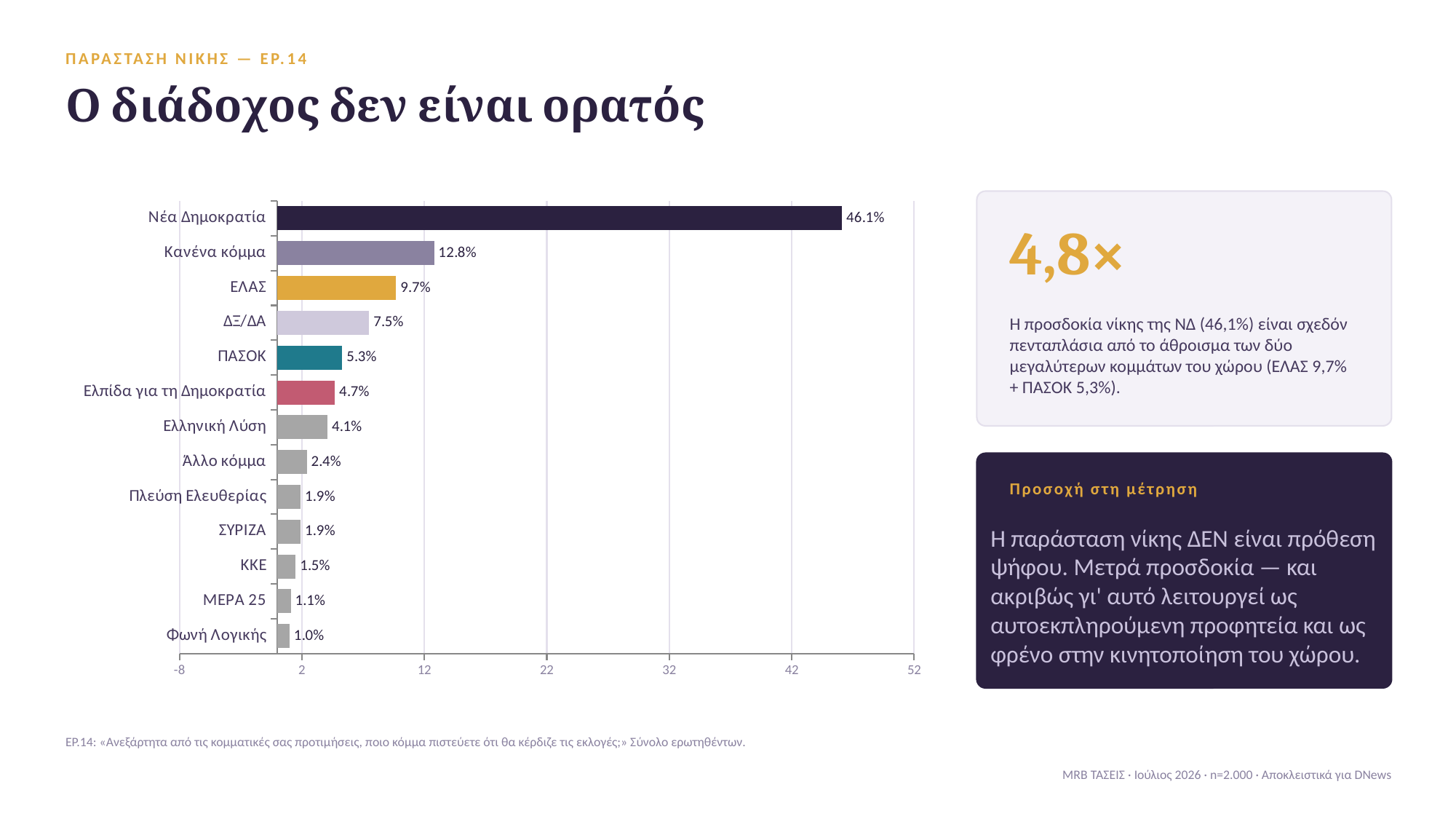
Is the value for Ελπίδα για τη Δημοκρατία greater or less than 12? less Which category has the lowest value? Φωνή Λογικής What is the difference between the values for Νέα Δημοκρατία and Κανένα κόμμα? 33.3 percentage points What kind of chart is shown on the slide? bar chart What is the value for Νέα Δημοκρατία? 46.1% How many categories are shown in the chart? 13 What is the value for Κανένα κόμμα? 12.8% What is the difference between the values for ΕΛΑΣ and ΠΑΣΟΚ? 4.4 percentage points Which is larger, the value for ΔΞ/ΔΑ or the value for ΕΛΑΣ? ΕΛΑΣ What is the value for ΠΑΣΟΚ? 5.3% What is the value for Ελληνική Λύση? 4.1% Which category has the highest value? Νέα Δημοκρατία